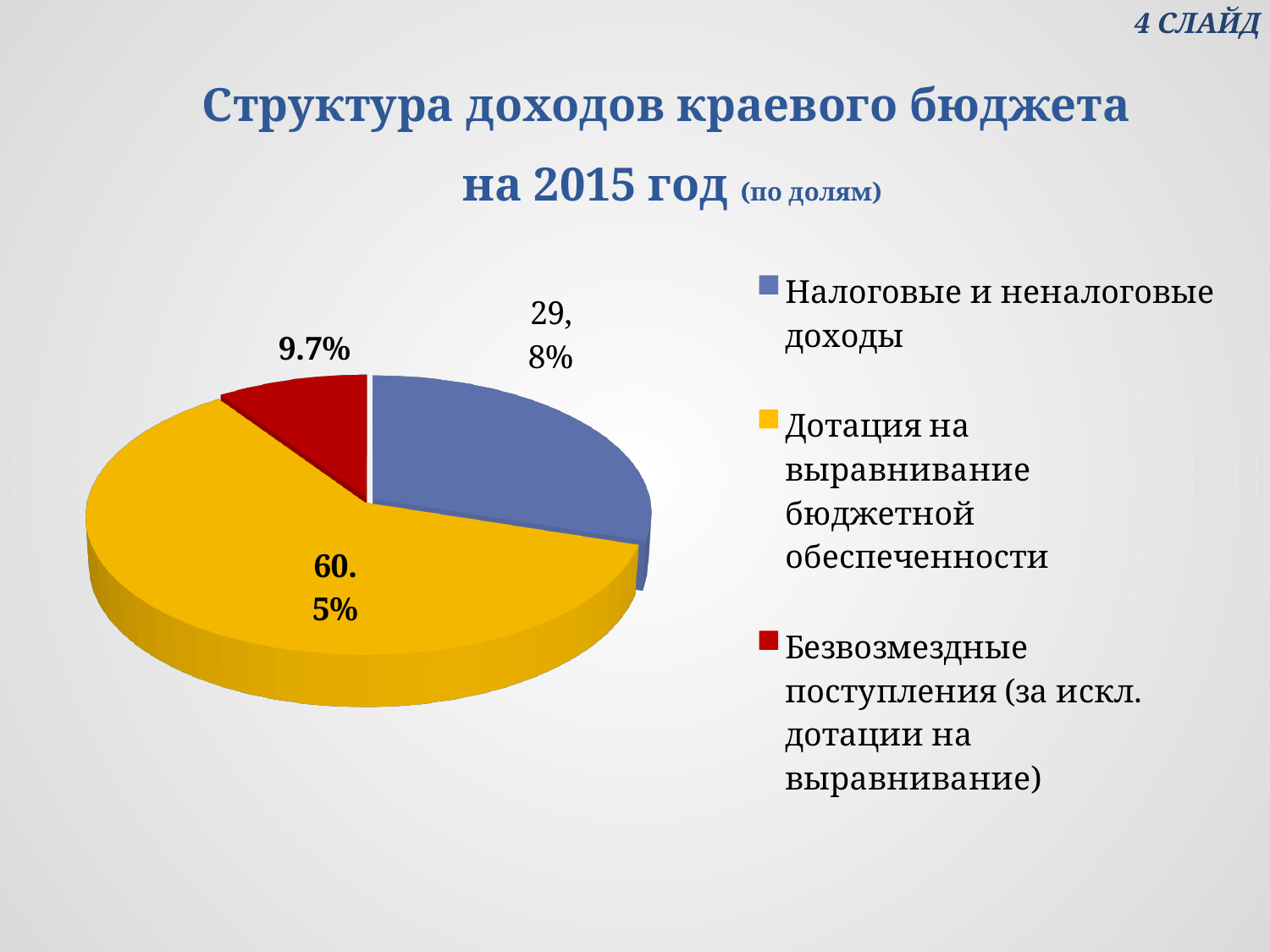
Which category has the largest slice of the pie? Дотация на выравнивание бюджетной обеспеченности How many slices does the pie chart have? 3 Which category has the smallest slice of the pie? Безвозмездные поступления (за искл. дотации на выравнивание) What share of the pie is labelled for Безвозмездные поступления (за искл. дотации на выравнивание)? 9.7% How many entries does the legend list? 3 What share of the pie is labelled for Налоговые и неналоговые доходы? 29,8% Which is larger: the slice for Налоговые и неналоговые доходы or the slice for Безвозмездные поступления (за искл. дотации на выравнивание)? Налоговые и неналоговые доходы What kind of chart is shown on the slide? pie chart What share of the pie is labelled for Дотация на выравнивание бюджетной обеспеченности? 60.5% What colour is the slice for Дотация на выравнивание бюджетной обеспеченности? yellow What colour is the slice for Безвозмездные поступления (за искл. дотации на выравнивание)? red